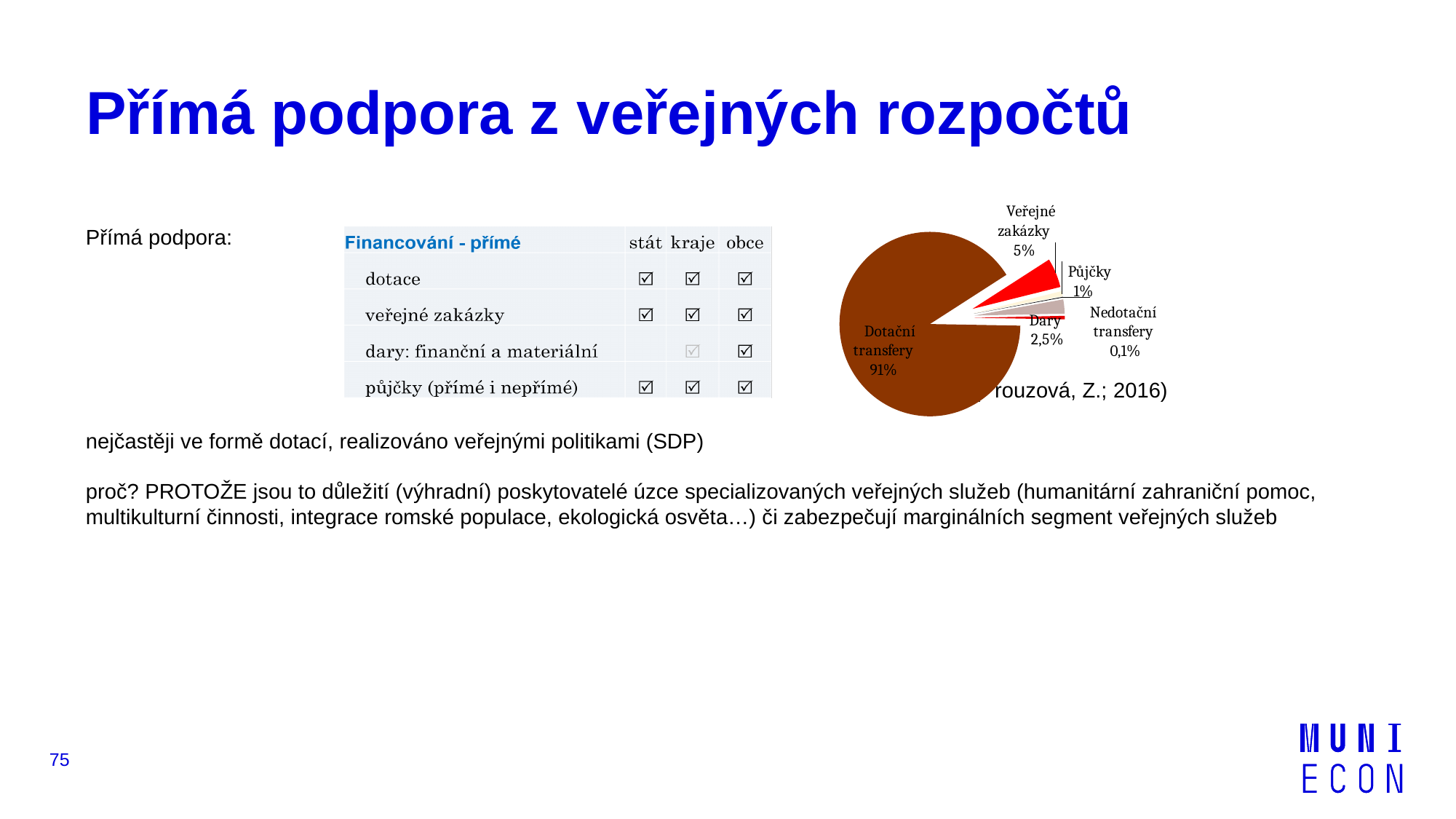
What kind of chart is shown on the slide? pie chart What share of the pie does Veřejné zakázky have? 5% Which slice of the pie chart is the largest? Dotační transfery Which is larger in the pie chart, Veřejné zakázky or Dary? Veřejné zakázky What share of the pie does Dary have? 2,5% What share of the pie does Půjčky have? 1% What is the difference in percentage points between Dotační transfery and Veřejné zakázky? 86 What is the difference in percentage points between Dary and Půjčky? 1,5 Which slice of the pie chart is the smallest? Nedotační transfery How many slices does the pie chart have? 6